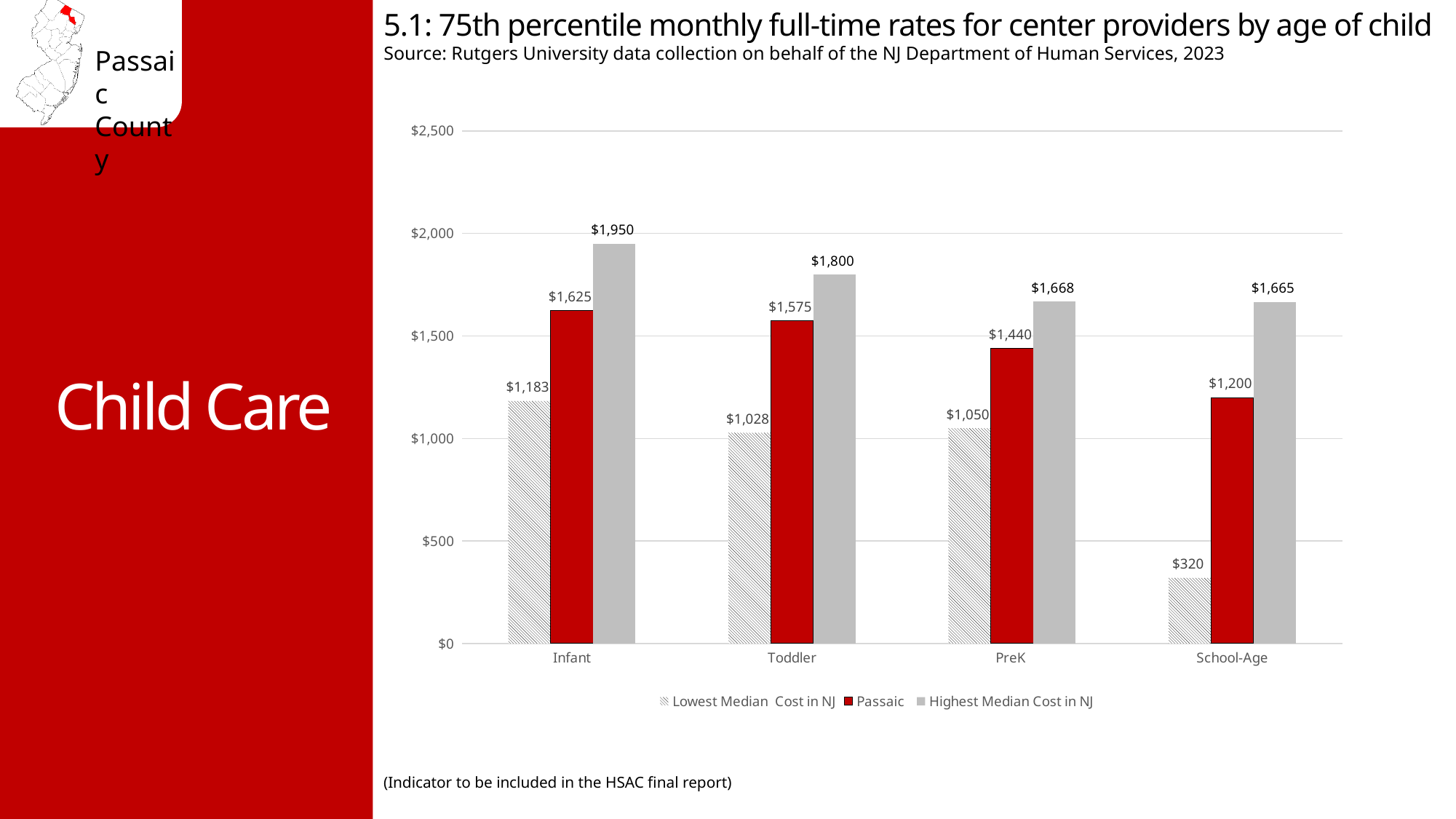
How many age categories are shown on the x axis? 4 What is the Highest Median Cost in NJ for Toddler? $1,800 What is the Lowest Median Cost in NJ for School-Age? $320 Is the Passaic value for School-Age greater or less than $1,500? less Which age category has the highest Passaic value? Infant What is the Passaic value for Infant? $1,625 Which age category has the lowest Lowest Median Cost in NJ value? School-Age Which series is shown in red? Passaic Which is larger for Toddler: the Passaic value or the Lowest Median Cost in NJ value? Passaic What kind of chart is shown? bar chart How many series does the legend list? 3 What is the difference between the Highest Median Cost in NJ and the Passaic value for PreK? $228